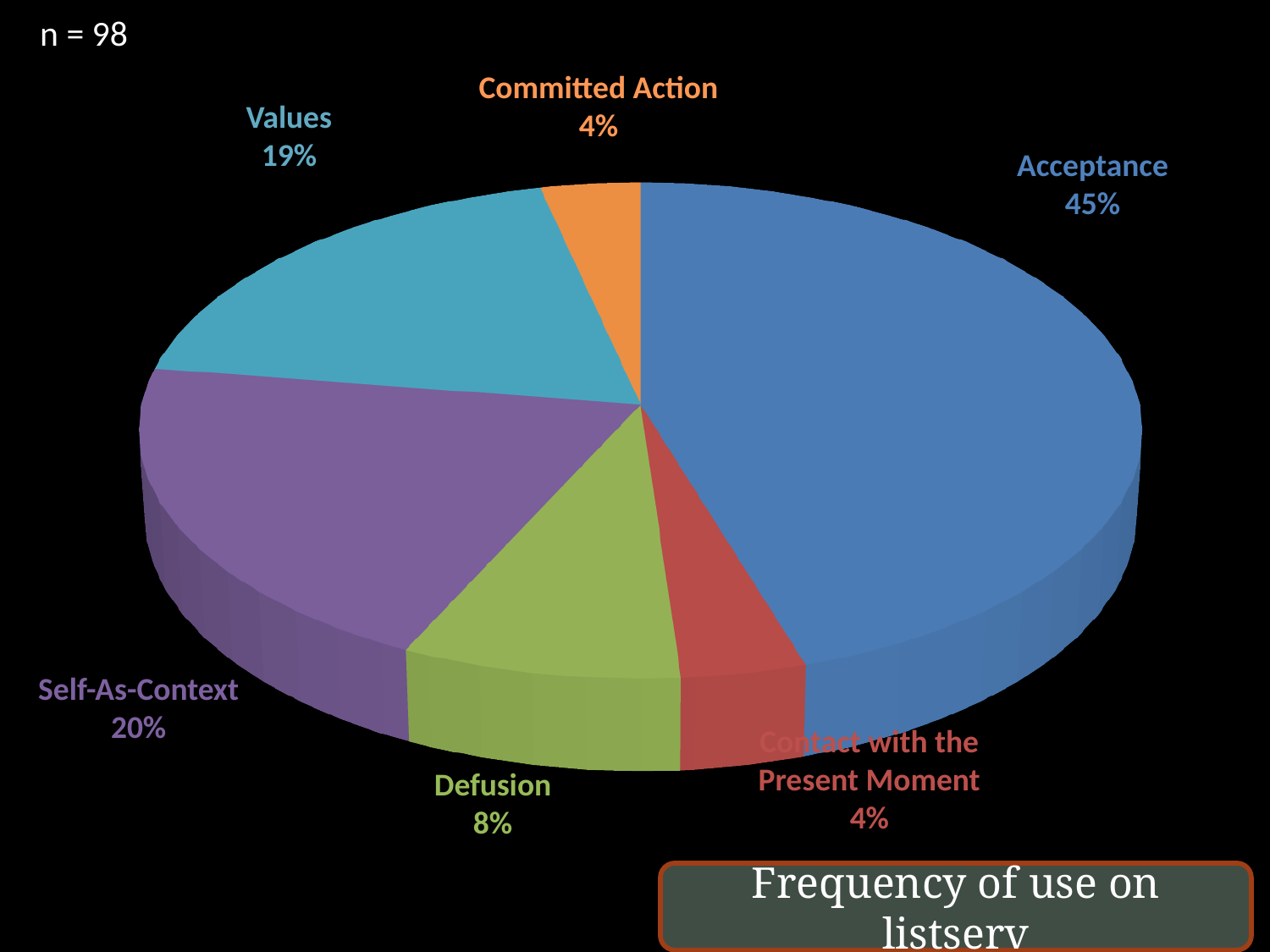
What share is shown for Self-As-Context? 20% What share does Values have in the pie chart? 19% What is the title shown in the box on the slide? Frequency of use on listserv What type of chart is shown on the slide? Pie chart What percentage of the pie does Acceptance account for? 45% Which has the larger share, Self-As-Context or Values? Self-As-Context What percentage is labelled for Defusion? 8% What percentage is shown for Contact with the Present Moment? 4% How many categories are shown in the pie chart? 6 What is the difference in percentage points between Acceptance and Self-As-Context? 25 Which has the larger share, Defusion or Committed Action? Defusion Which category has the largest slice of the pie? Acceptance